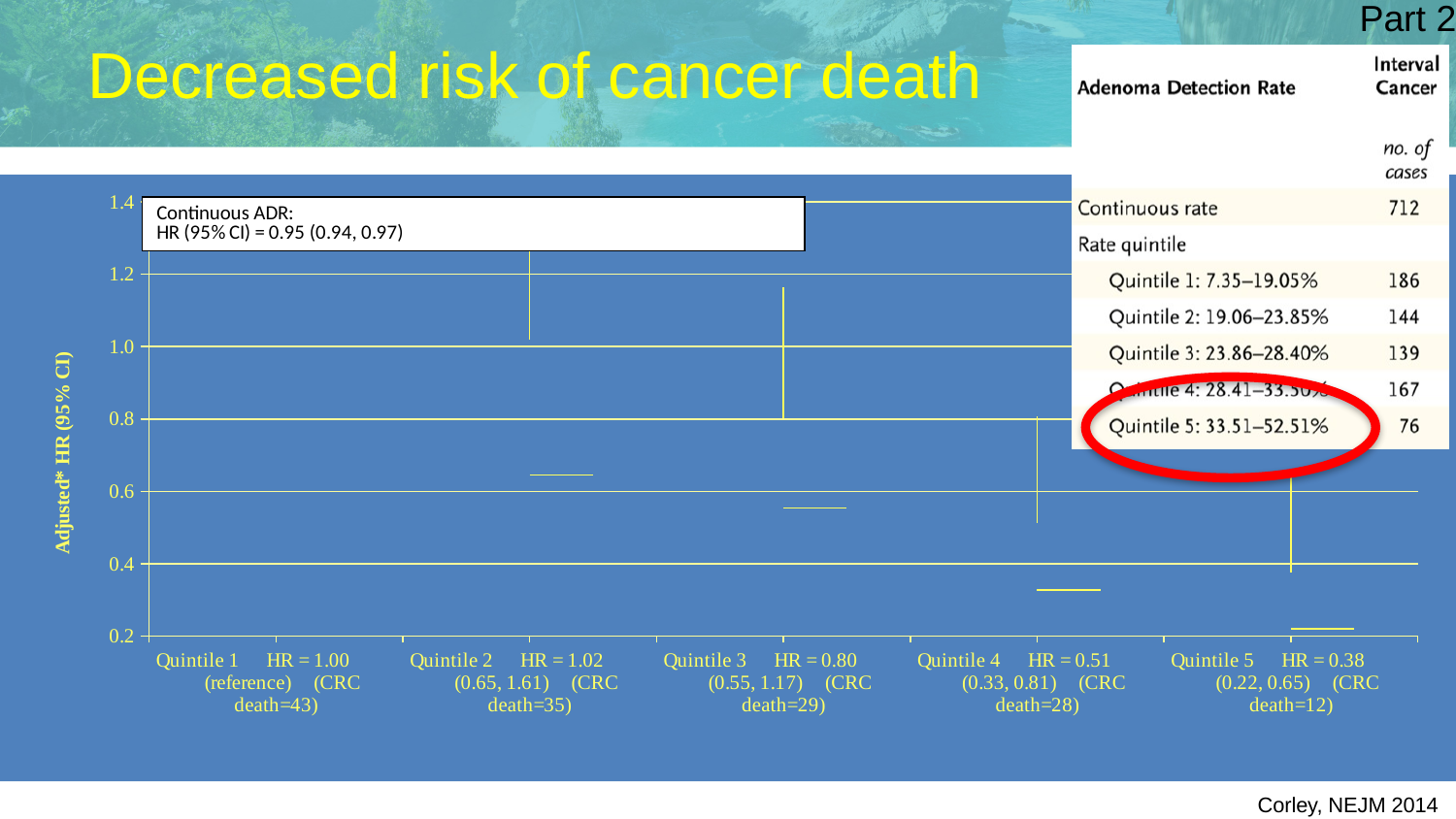
How many quintiles are plotted on the x axis? 5 What is the difference between the HR for Quintile 1 and the HR for Quintile 4? 0.49 What is the 95% CI for the HR of Quintile 5? (0.22, 0.65) Is the HR for Quintile 4 greater or less than 0.6? less What is the HR for Quintile 3? 0.80 How many CRC deaths are reported for Quintile 4? 28 What is the label of the y axis? Adjusted* HR (95% CI) Does the HR rise or fall from Quintile 2 to Quintile 5? fall Which quintile has the highest HR? Quintile 2 Which quintile has the lowest HR? Quintile 5 Which has the larger HR, Quintile 3 or Quintile 4? Quintile 3 What is the HR for Quintile 5? 0.38